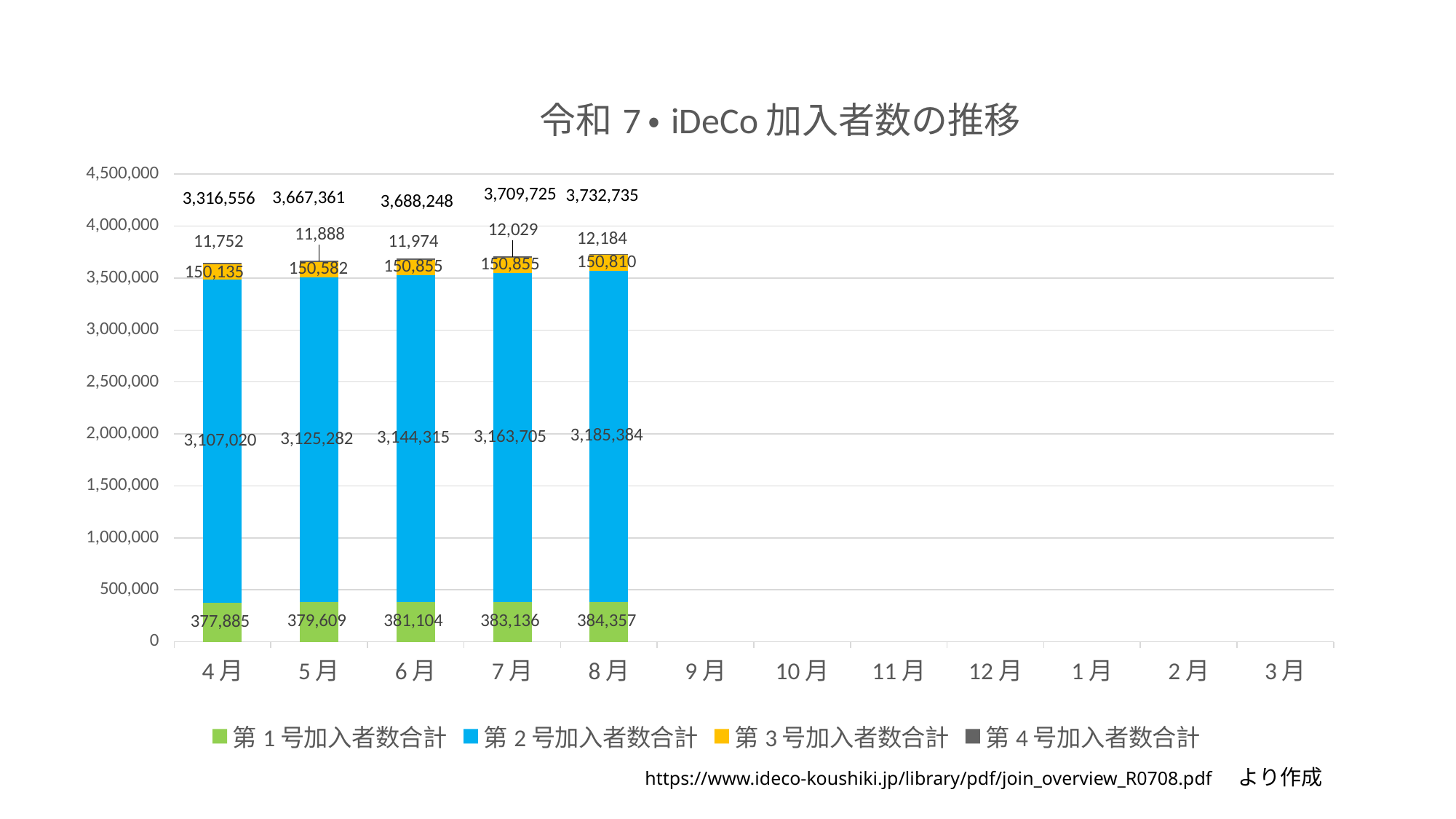
What is the total of the stacked bar for 8月? 3,732,735 Which month has the highest value for 第２号加入者数合計? 8月 How many series does the legend list? 4 What kind of chart is shown on the slide? Stacked bar chart What is the value of 第２号加入者数合計 for 8月? 3,185,384 What is the difference between the 第２号加入者数合計 values for 8月 and 7月? 21,679 Which month has the lowest value for 第１号加入者数合計? 4月 What is the value of 第１号加入者数合計 for 4月? 377,885 Which is larger, the 第４号加入者数合計 value for 5月 or for 7月? 7月 What is the value of 第３号加入者数合計 for 5月? 150,582 Do the 第１号加入者数合計 values rise or fall from 4月 to 8月? Rise What is the value of 第４号加入者数合計 for 6月? 11,974